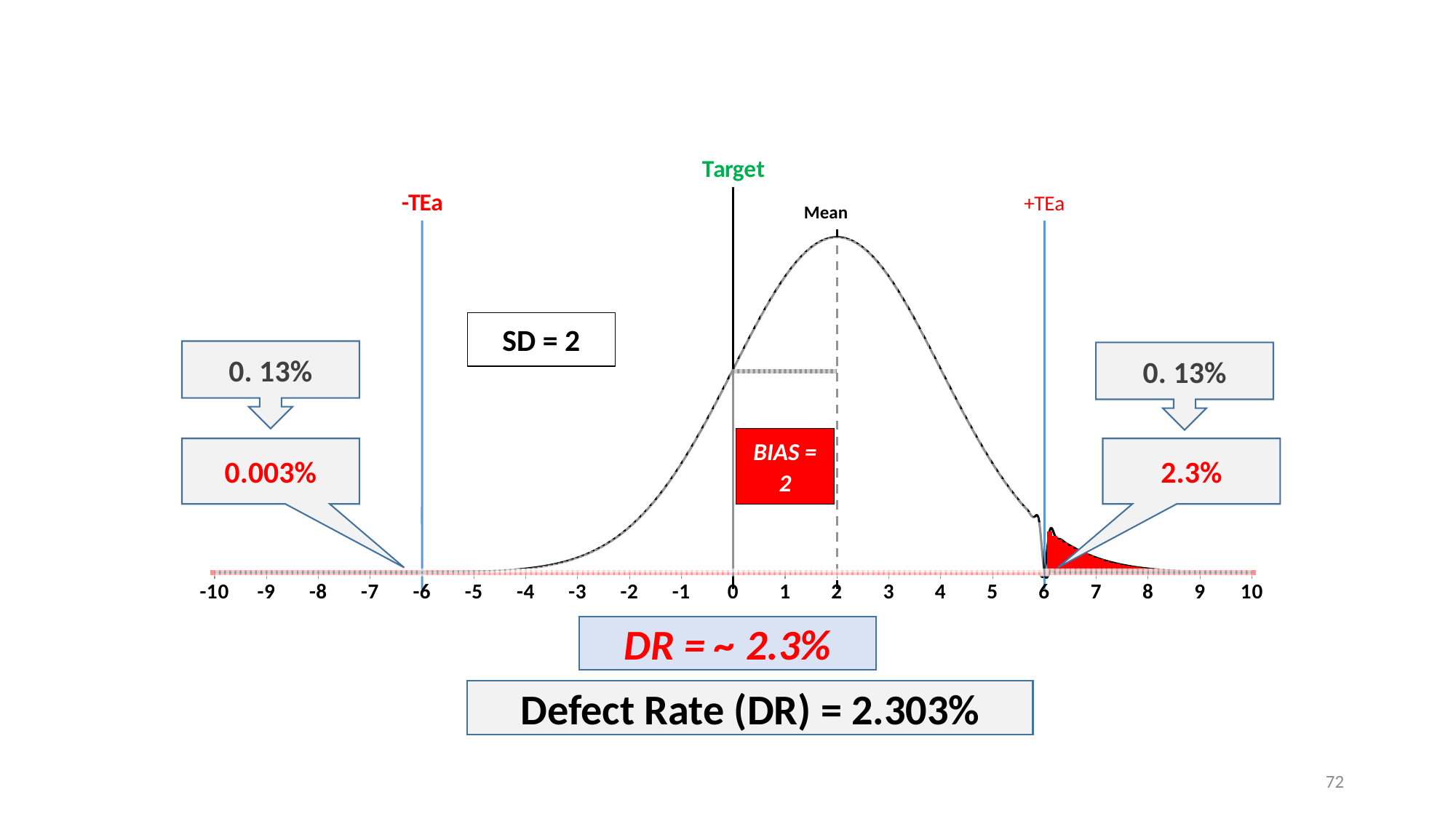
What kind of chart is shown on the slide? Line chart (bell curve) At what x-axis value is the -TEa line located? -6 What percentage is shown in the callout pointing to the tail beyond -TEa? 0.003% What percentage is shown in the callout pointing to the tail beyond +TEa? 2.3% What is the SD value shown on the chart? 2 What is the difference on the x-axis between the Mean and the Target? 2 What is the Defect Rate (DR) stated below the chart? 2.303% At what x-axis value is the Target located? 0 At what x-axis value is the +TEa line located? 6 What is the BIAS value shown on the chart? 2 Which tail has the larger percentage, the one beyond -TEa or the one beyond +TEa? +TEa At what x-axis value is the Mean located? 2